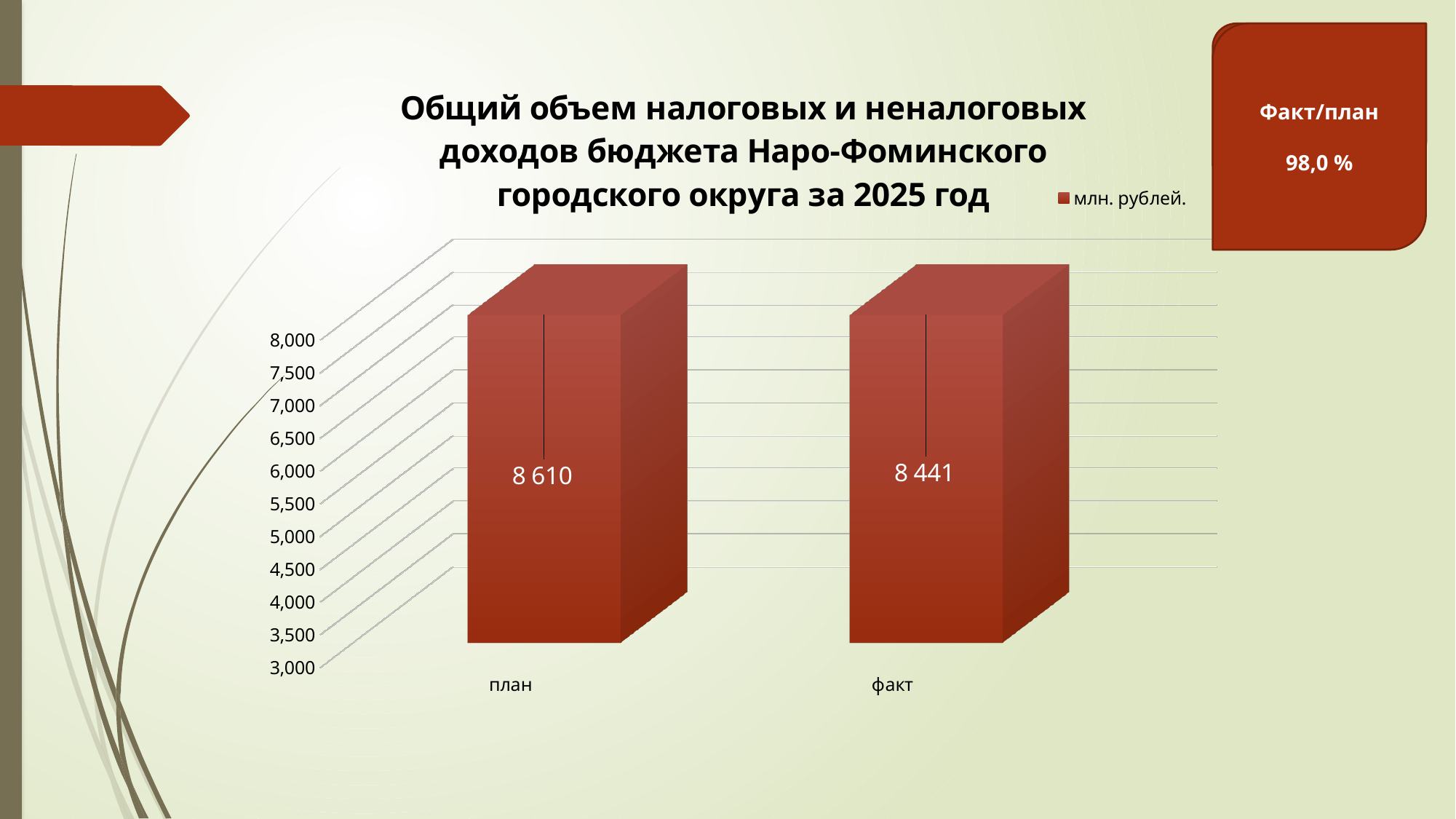
What is the value for факт? 8 441 Do the values rise or fall from план to факт? fall What is the difference between the values for план and факт? 169 Is the value for факт greater or less than 8,000? greater How many categories are shown on the x axis? 2 Which category has the highest value? план How many series does the legend list? 1 What is the value for план? 8 610 What series name is shown in the legend? млн. рублей. Which is larger, the value for план or the value for факт? план Which category has the lowest value? факт What kind of chart is shown on the slide? bar chart